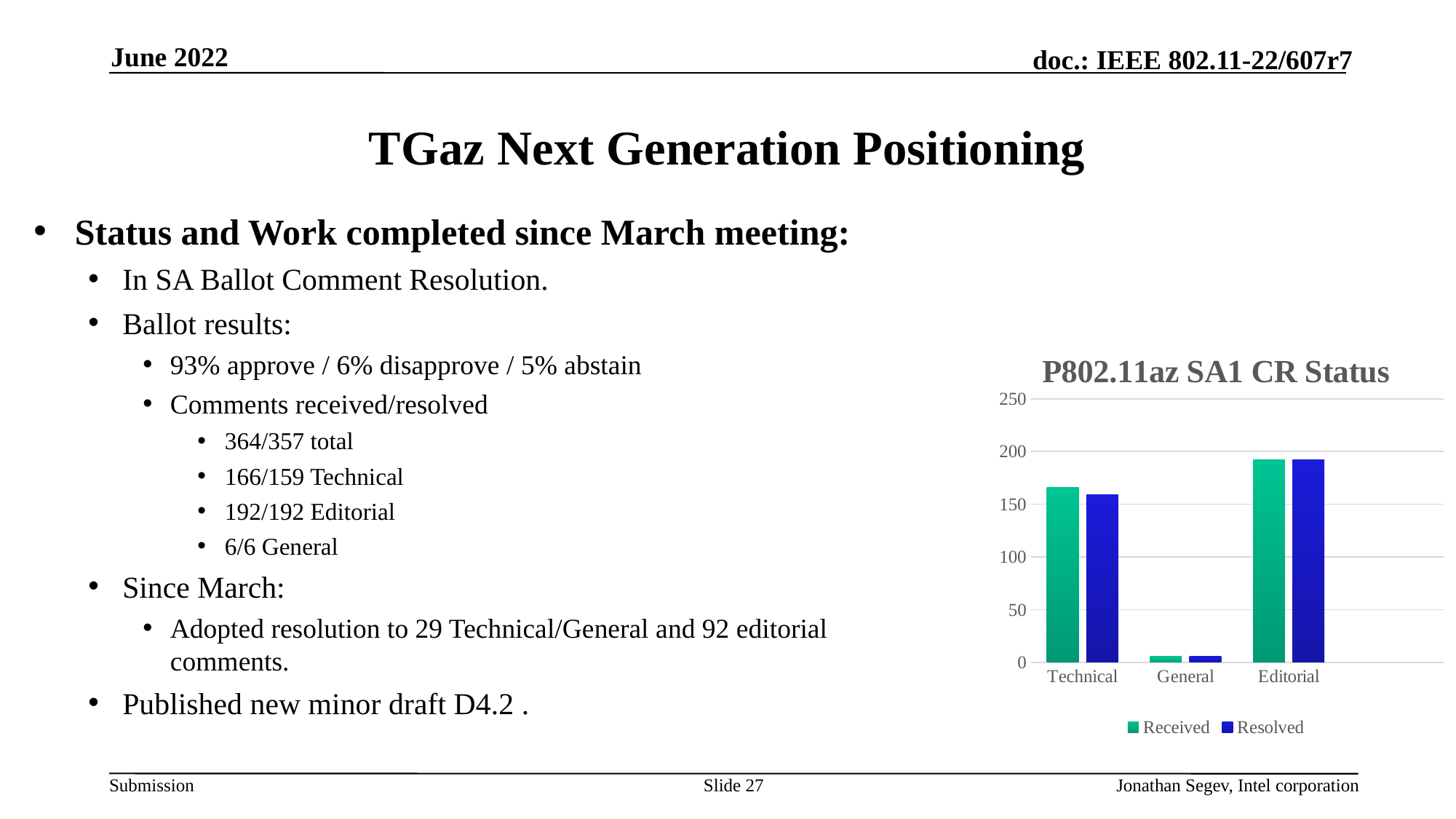
Which category has the highest Received value? Editorial How many series does the chart's legend list? 2 Is the Received value for Technical greater or less than 150? greater Is the Received value for General greater or less than 50? less Which is larger, the Received value for Editorial or the Received value for Technical? Editorial Is the Resolved value for Editorial greater or less than 200? less Which series is shown in blue in the chart? Resolved How many categories are shown on the x axis of the chart? 3 What kind of chart is shown on the slide? bar chart Which category has the lowest Resolved value? General What is the title of the chart? P802.11az SA1 CR Status